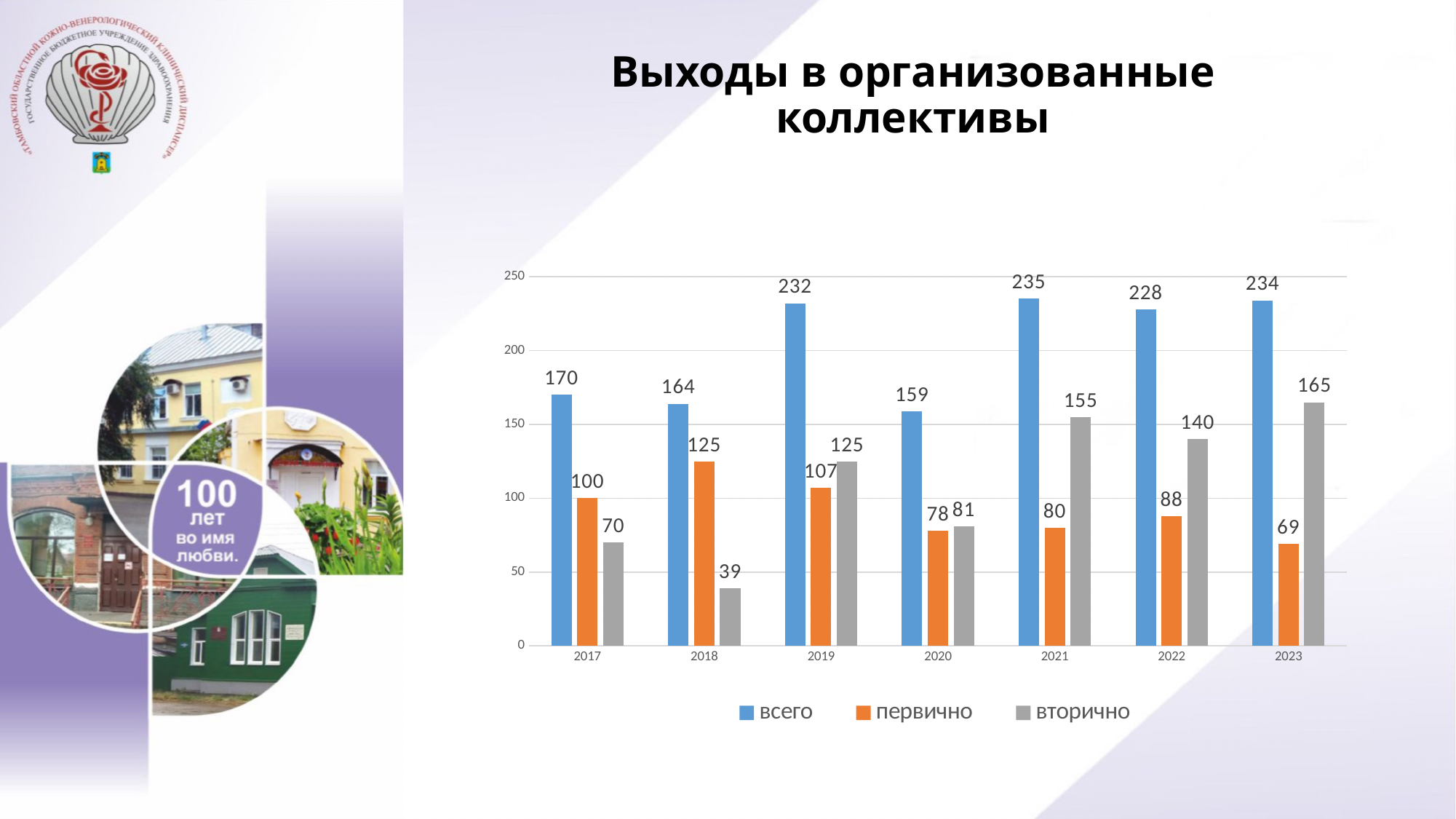
How many series does the legend list? 3 What is the value of "вторично" for 2023? 165 In which year is the "всего" value highest? 2021 What is the value of "первично" for 2018? 125 Which is larger in 2020: "первично" or "вторично"? вторично How many years are shown on the x axis? 7 Is the "всего" value for 2022 greater or less than 200? greater What type of chart is shown on the slide? bar chart What is the value of "всего" for 2019? 232 What is the title of the chart? Выходы в организованные коллективы In which year is the "вторично" value lowest? 2018 What is the difference between "всего" and "первично" in 2017? 70